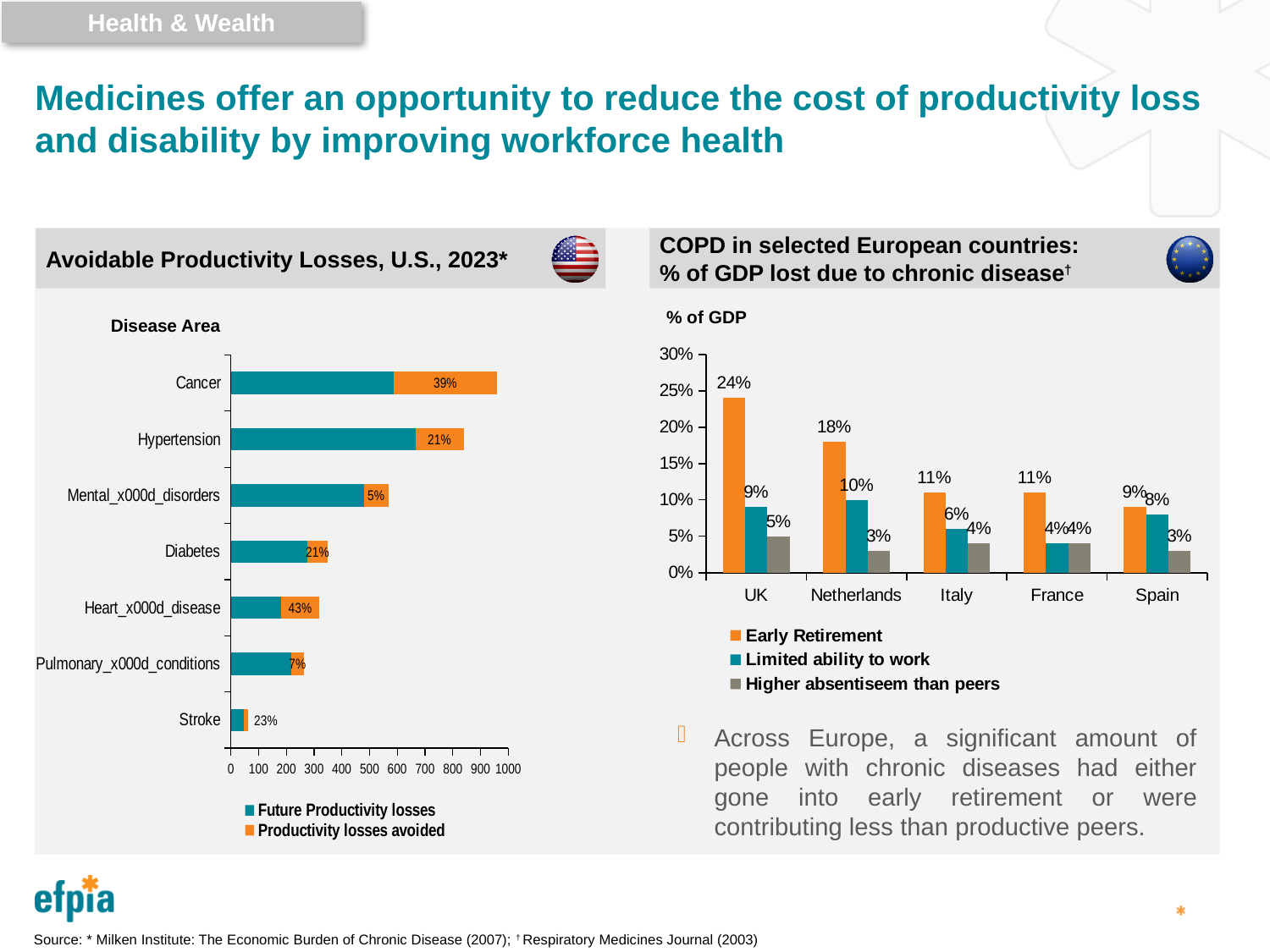
In the COPD in selected European countries chart, what is the Limited ability to work value for the Netherlands? 10% In the Avoidable Productivity Losses, U.S., 2023 chart, is the total bar length for Cancer greater or less than 900? greater What kind of chart is the Avoidable Productivity Losses, U.S., 2023 chart? bar chart In the Avoidable Productivity Losses, U.S., 2023 chart, is the total bar length for Stroke greater or less than 100? less How many countries are shown in the COPD in selected European countries chart? 5 In the COPD in selected European countries chart, what is the difference between the Early Retirement values for the UK and the Netherlands? 6% How many disease areas are shown in the Avoidable Productivity Losses, U.S., 2023 chart? 7 In the COPD in selected European countries chart, which is larger: the Limited ability to work value for Italy or for France? Italy In the COPD in selected European countries chart, which country has the highest Early Retirement value? UK In the COPD in selected European countries chart, what is the Early Retirement value for the UK? 24% In the COPD in selected European countries chart, what is the Higher absentiseem than peers value for Spain? 3% How many series does the legend of the COPD in selected European countries chart list? 3